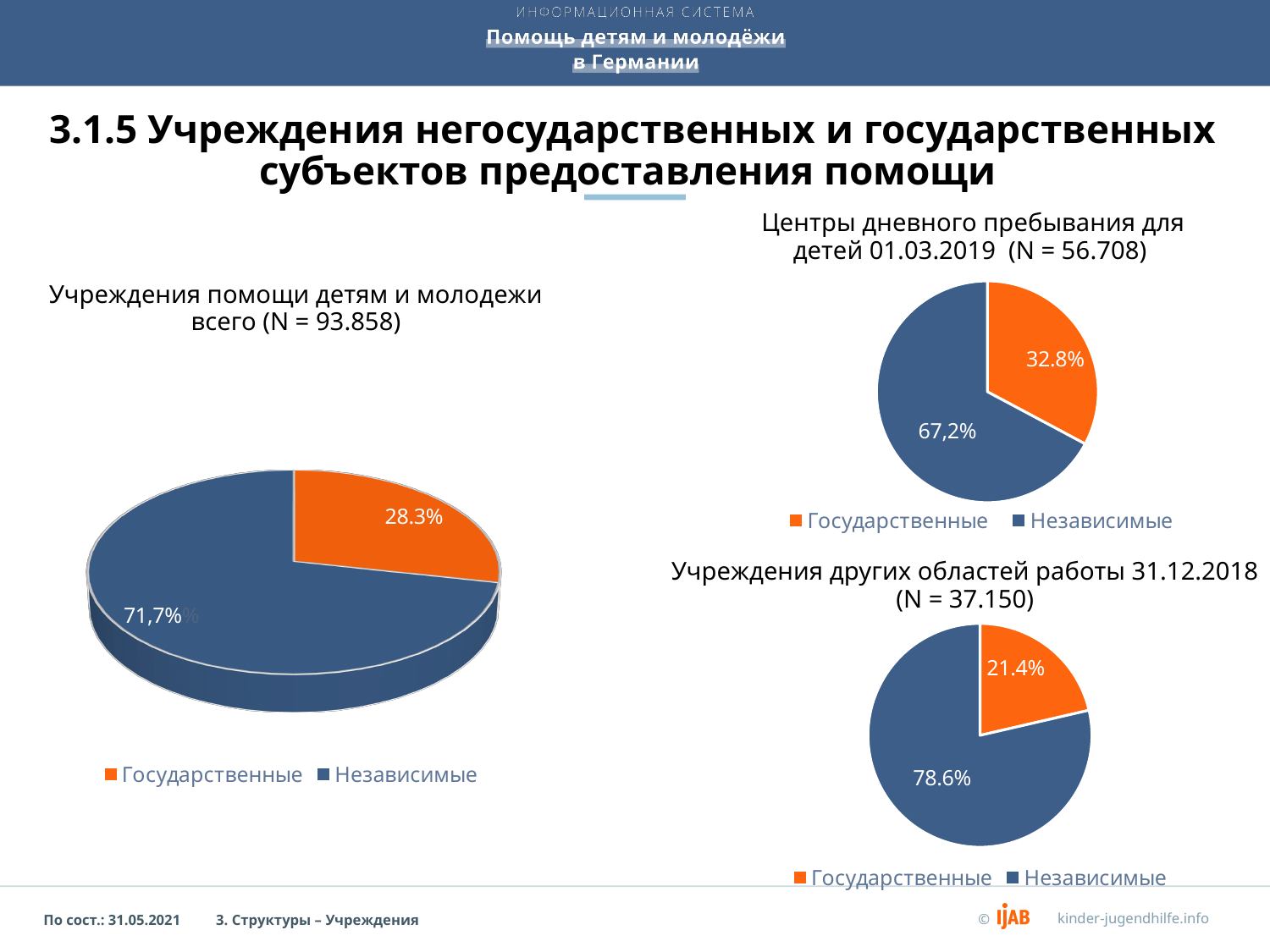
In the chart titled "Учреждения других областей работы 31.12.2018 (N = 37.150)", what is the difference between the Независимые and Государственные shares? 57.2% In the chart titled "Учреждения помощи детям и молодежи всего (N = 93.858)", what share is labelled for Независимые? 71,7% What type of chart is the one titled "Учреждения помощи детям и молодежи всего (N = 93.858)"? Pie chart How many entries does the legend of the chart titled "Центры дневного пребывания для детей 01.03.2019 (N = 56.708)" list? 2 In the chart titled "Учреждения других областей работы 31.12.2018 (N = 37.150)", which category has the largest slice? Независимые In the chart titled "Учреждения других областей работы 31.12.2018 (N = 37.150)", what share is labelled for Независимые? 78.6% In the chart titled "Учреждения помощи детям и молодежи всего (N = 93.858)", what colour is the Государственные slice? Orange In the chart titled "Центры дневного пребывания для детей 01.03.2019 (N = 56.708)", which category has the smallest slice? Государственные In the chart titled "Центры дневного пребывания для детей 01.03.2019 (N = 56.708)", what share is labelled for Государственные? 32.8% In the chart titled "Учреждения других областей работы 31.12.2018 (N = 37.150)", what share is labelled for Государственные? 21.4% In the chart titled "Центры дневного пребывания для детей 01.03.2019 (N = 56.708)", what share is labelled for Независимые? 67,2% In the chart titled "Учреждения помощи детям и молодежи всего (N = 93.858)", what share is labelled for Государственные? 28.3%